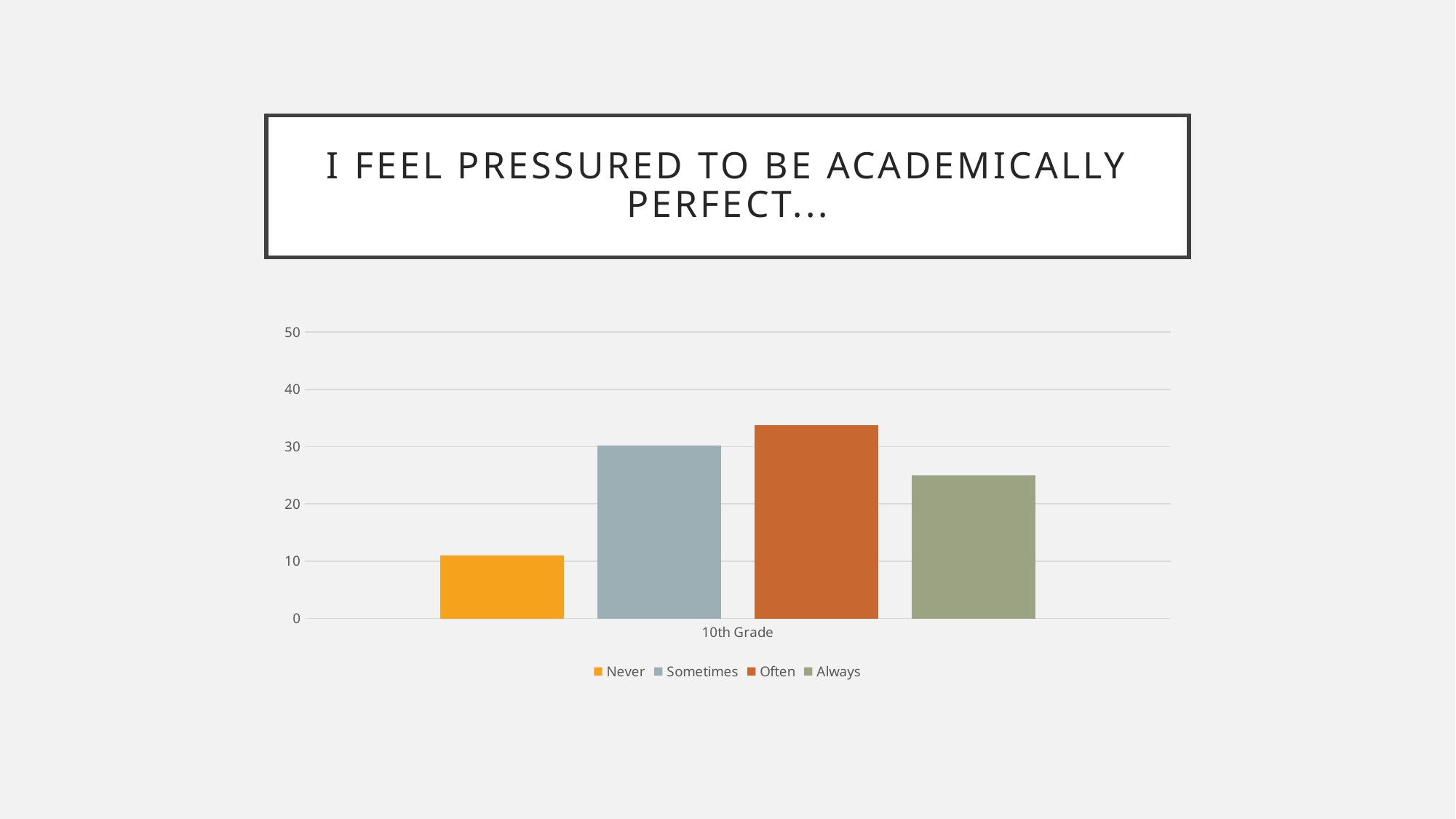
Is the value for Often greater or less than 40? less Is the value for Always greater or less than 20? greater What kind of chart is shown on the slide? bar chart Which is larger for 10th Grade, Sometimes or Always? Sometimes How many series does the legend list? 4 Which is larger for 10th Grade, Often or Always? Often Which series has the lowest bar for 10th Grade? Never Which series has the highest bar for 10th Grade? Often Is the value for Often greater or less than 30? greater What is the title of the slide? I FEEL PRESSURED TO BE ACADEMICALLY PERFECT... How many categories are shown on the x axis? 1